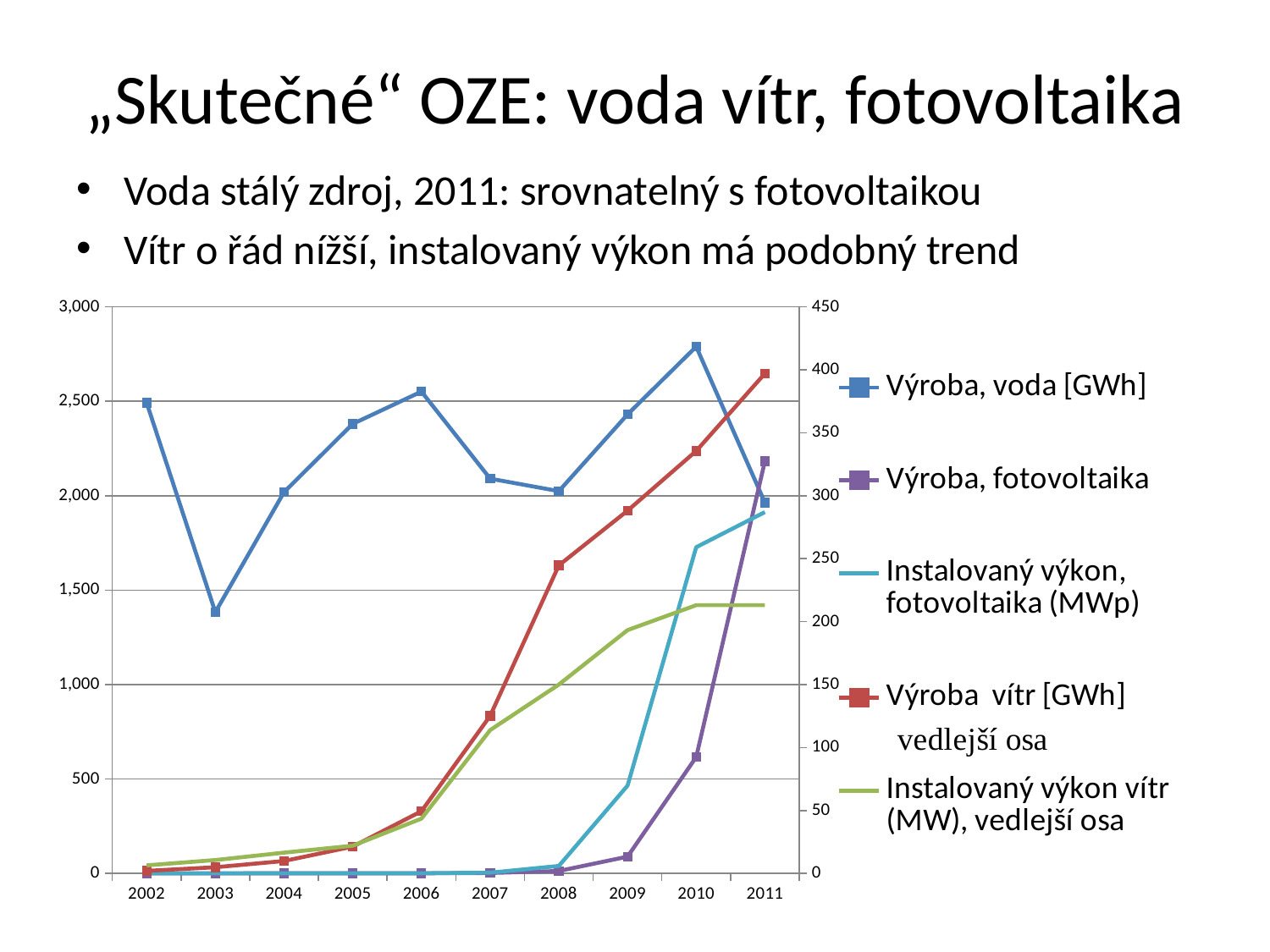
Which is larger for Výroba, voda [GWh]: the value in 2002 or the value in 2011? 2002 In which year is Výroba, voda [GWh] lowest? 2003 Is the value for Výroba, voda [GWh] in 2010 greater or less than 2,500? greater How many series does the legend list? 5 Does Výroba, fotovoltaika rise or fall from 2008 to 2011? rise In which year is Výroba, voda [GWh] highest? 2010 How many years are shown on the x axis? 10 Which series are plotted on the secondary axis (vedlejší osa)? Výroba vítr [GWh] and Instalovaný výkon vítr (MW) What kind of chart is shown on the slide? line chart Is the value for Výroba vítr [GWh] in 2011 greater or less than 350 on the secondary axis? greater Is the value for Výroba, voda [GWh] in 2003 greater or less than 1,500? less In which year is Výroba vítr [GWh] highest? 2011